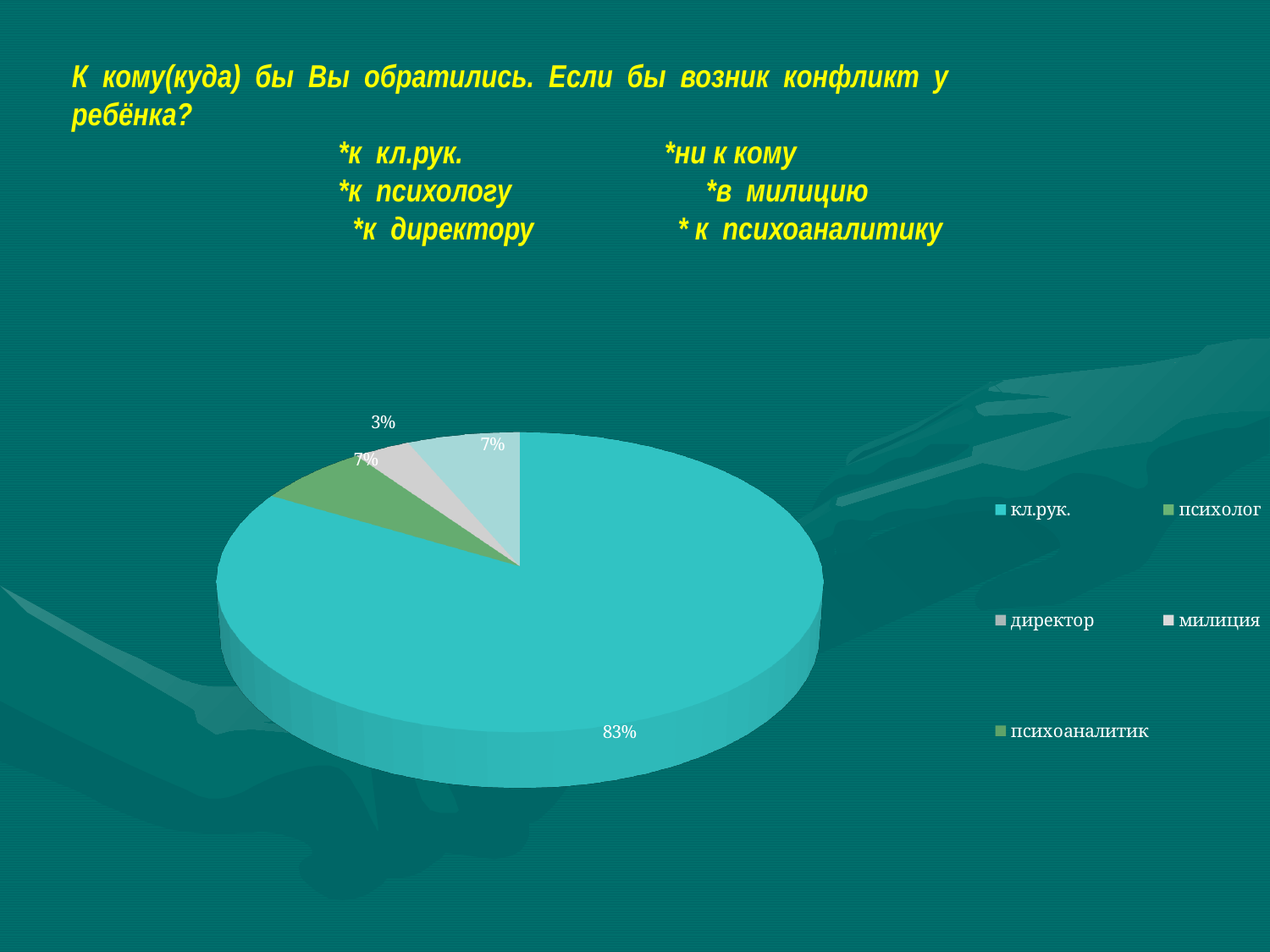
What kind of chart is shown on the slide? pie chart Which legend entry is listed last in the pie chart's legend? психоаналитик What percentage is shown for the green психолог slice? 7% How many categories does the legend of the pie chart list? 5 What is the smallest percentage label shown on the pie chart? 3% What percentage of the pie is labelled for кл.рук.? 83% Is the share for кл.рук. greater or less than 50%? greater What colour is the largest slice of the pie chart? teal What is the difference between the кл.рук. share (83%) and the психолог share (7%)? 76% Which category has the largest slice of the pie chart? кл.рук. Which is larger, the share for кл.рук. or the share for психолог? кл.рук.